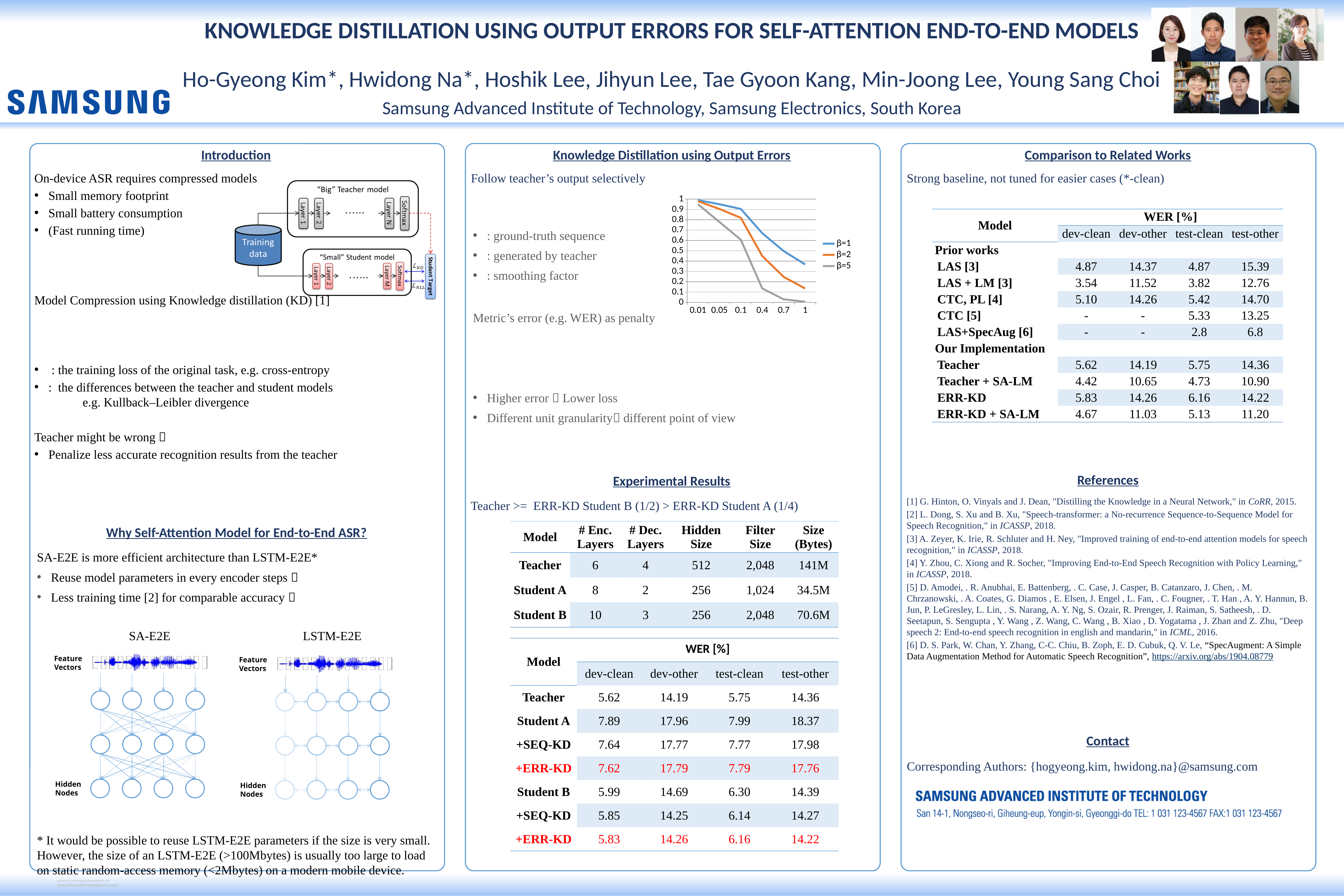
In the line chart, is the value of the β=2 series at x = 0.1 greater or less than 0.7? greater How many x-axis tick values are shown on the line chart? 6 What kind of chart is shown in the Knowledge Distillation using Output Errors section? line chart What colour is the β=2 line in the line chart? orange Do the values in the line chart rise or fall as the x axis goes from 0.01 to 1? fall In the line chart, is the value of the β=5 series at x = 0.4 greater or less than 0.3? less In the line chart, which series has the highest value at x = 1? β=1 In the line chart, which is larger at x = 0.4: the β=1 series or the β=5 series? β=1 In the line chart, is the value of the β=1 series at x = 1 greater or less than 0.5? less In the line chart, which series has the lowest value at x = 1? β=5 What are the legend entries of the line chart? β=1, β=2, β=5 How many series does the legend of the line chart list? 3